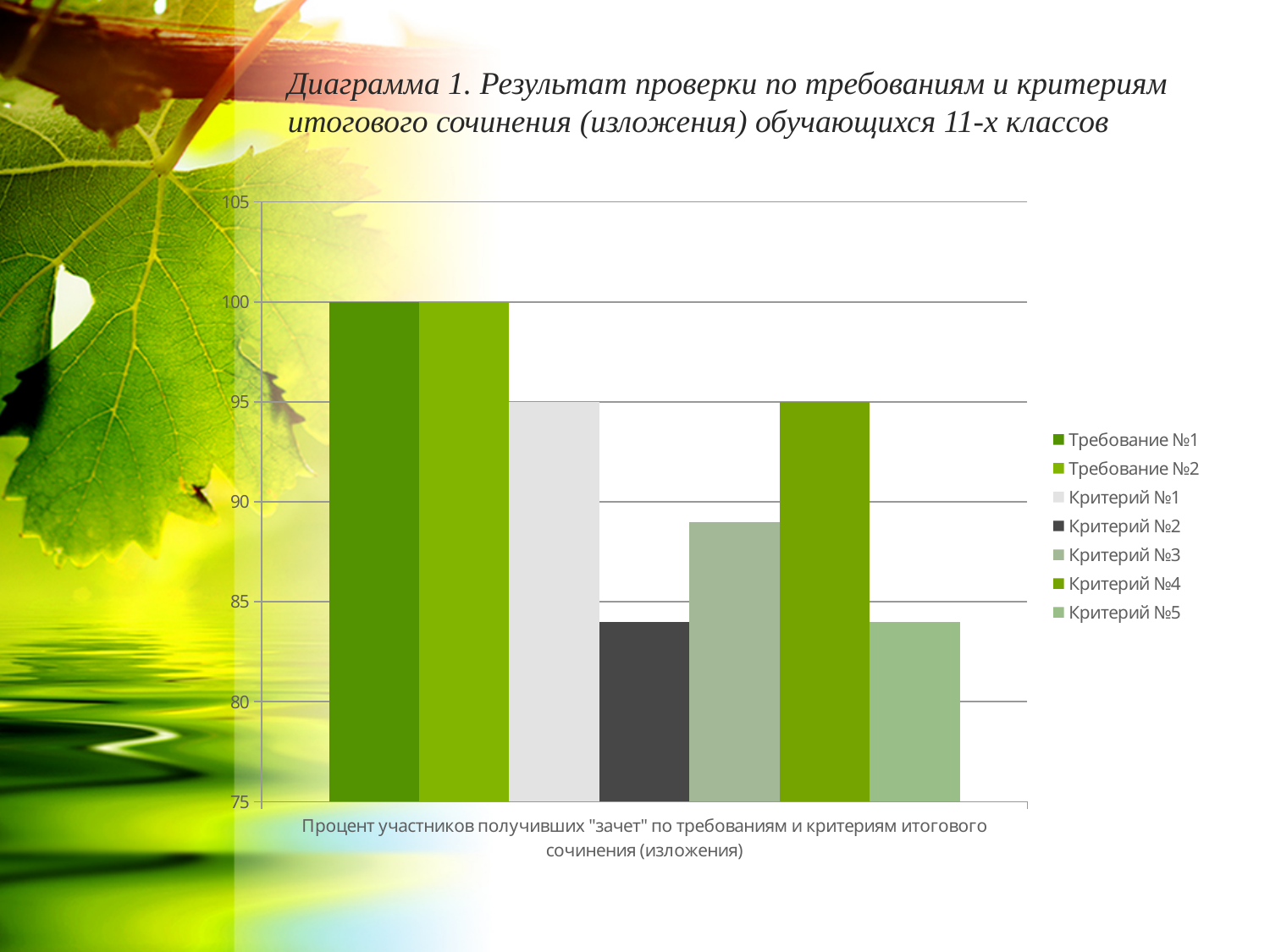
Is the value for Критерий №5 greater or less than 85? less Is the value for Критерий №2 greater or less than 85? less What is the value for Требование №2? 100 What is the value for Критерий №1? 95 What is the value for Критерий №4? 95 What type of chart is shown on the slide? bar chart What is the value for Требование №1? 100 Which is larger, the value for Критерий №1 or the value for Критерий №3? Критерий №1 What is the label of the category on the x axis? Процент участников получивших "зачет" по требованиям и критериям итогового сочинения (изложения) How many series does the legend list? 7 What is the difference between the value for Требование №1 and the value for Критерий №1? 5 Is the value for Критерий №3 greater or less than 90? less